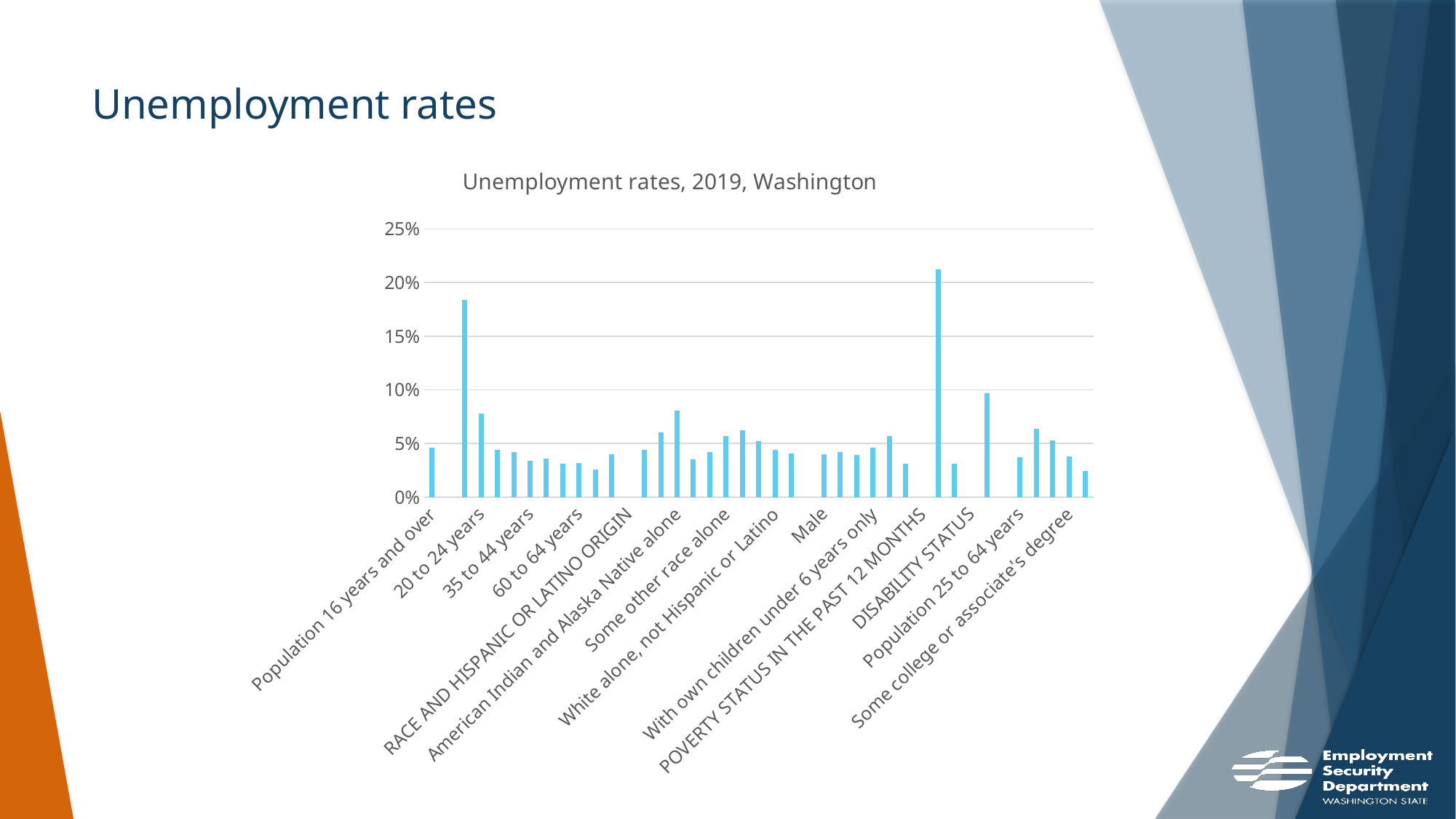
Is the value for Some college or associate's degree greater or less than 5%? less Is the value for 20 to 24 years greater or less than 10%? less Which has the higher unemployment rate, 20 to 24 years or 35 to 44 years? 20 to 24 years Is the value for American Indian and Alaska Native alone greater or less than 5%? greater What kind of chart is shown on the slide? Bar chart Which has the higher unemployment rate, 20 to 24 years or 60 to 64 years? 20 to 24 years What is the highest value shown on the vertical axis of the chart? 25% What is the title of the chart? Unemployment rates, 2019, Washington Which has the higher unemployment rate, American Indian and Alaska Native alone or White alone, not Hispanic or Latino? American Indian and Alaska Native alone